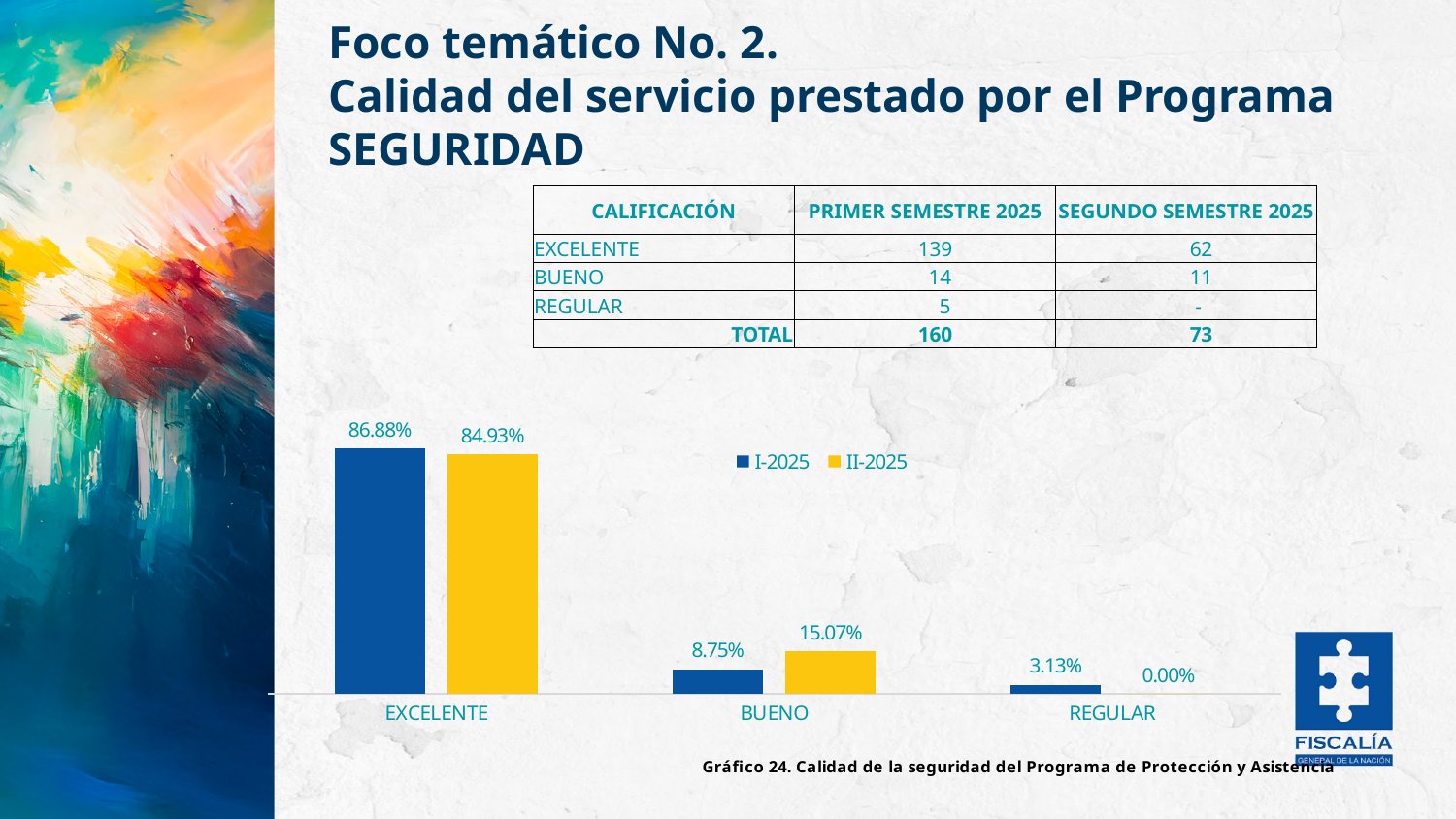
How many categories are shown on the x axis of the chart? 3 Which category has the lowest value in the I-2025 series? REGULAR What is the difference between the I-2025 and II-2025 values for BUENO? 6.32% What kind of chart is shown on the slide? Bar chart For EXCELENTE, which series has the larger value, I-2025 or II-2025? I-2025 How many series does the chart legend list? 2 What colour are the bars for the II-2025 series? Yellow Which category has the highest value in the II-2025 series? EXCELENTE What is the value for BUENO in the II-2025 series? 15.07% What is the value for REGULAR in the I-2025 series? 3.13% What is the value for REGULAR in the II-2025 series? 0.00% What is the value for EXCELENTE in the I-2025 series? 86.88%